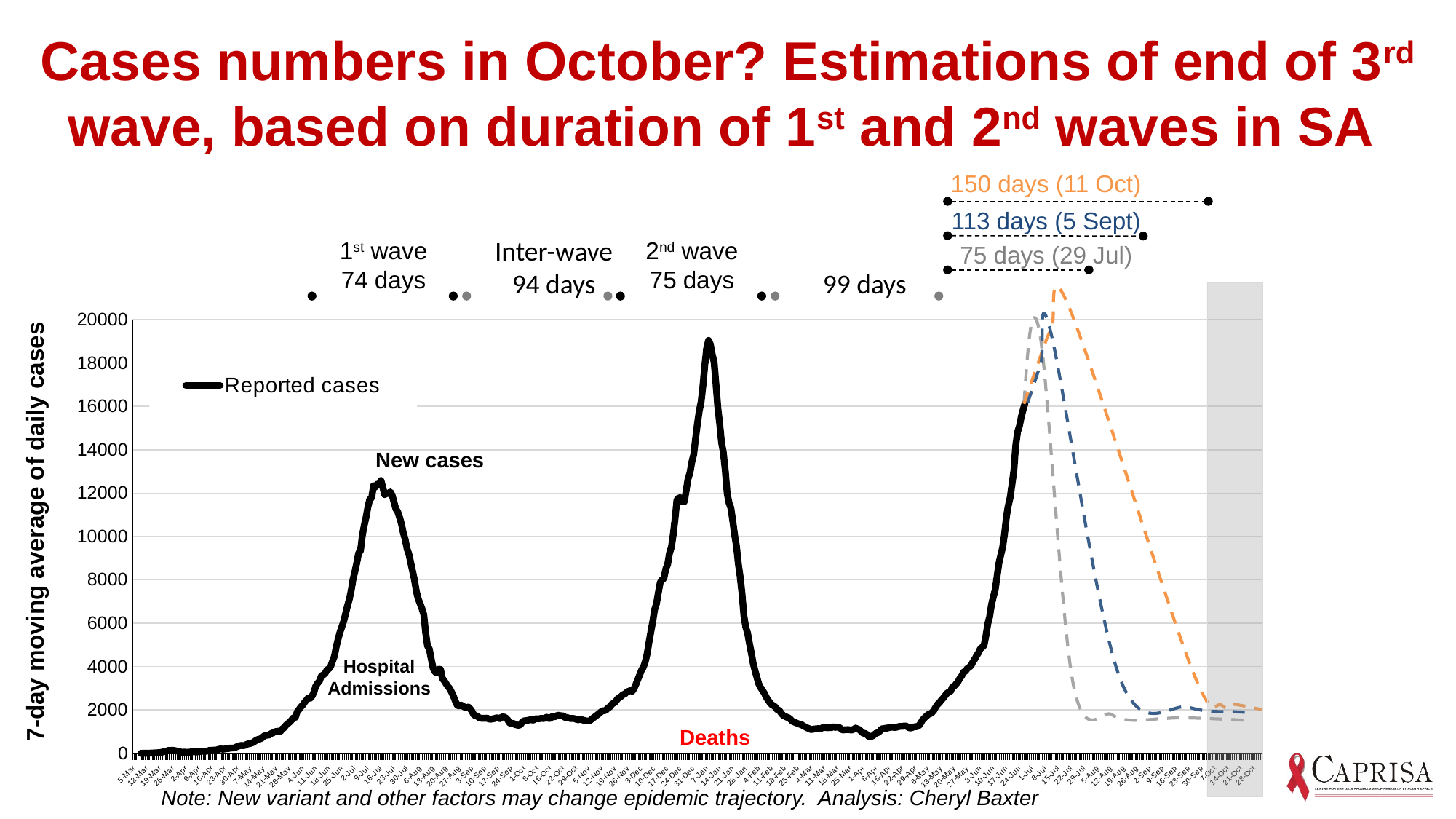
How many series does the chart legend list? 1 How many days did the 2nd wave last, according to the annotation above the chart? 75 days Is the peak of reported cases in the 2nd wave greater or less than 18000? greater Which of the three 3rd-wave scenarios has the longest duration? 150 days (11 Oct) What is the difference in days between the 150-day and 113-day scenarios? 37 days How many days did the 1st wave last, according to the annotation above the chart? 74 days What is the label of the y-axis? 7-day moving average of daily cases What end date is given for the 113-day scenario of the 3rd wave? 5 Sept What kind of chart is shown on the slide? line chart How long was the inter-wave period between the 1st and 2nd waves? 94 days Which peak of reported cases is higher, the 1st wave or the 2nd wave? 2nd wave What end date is given for the 150-day scenario of the 3rd wave? 11 Oct